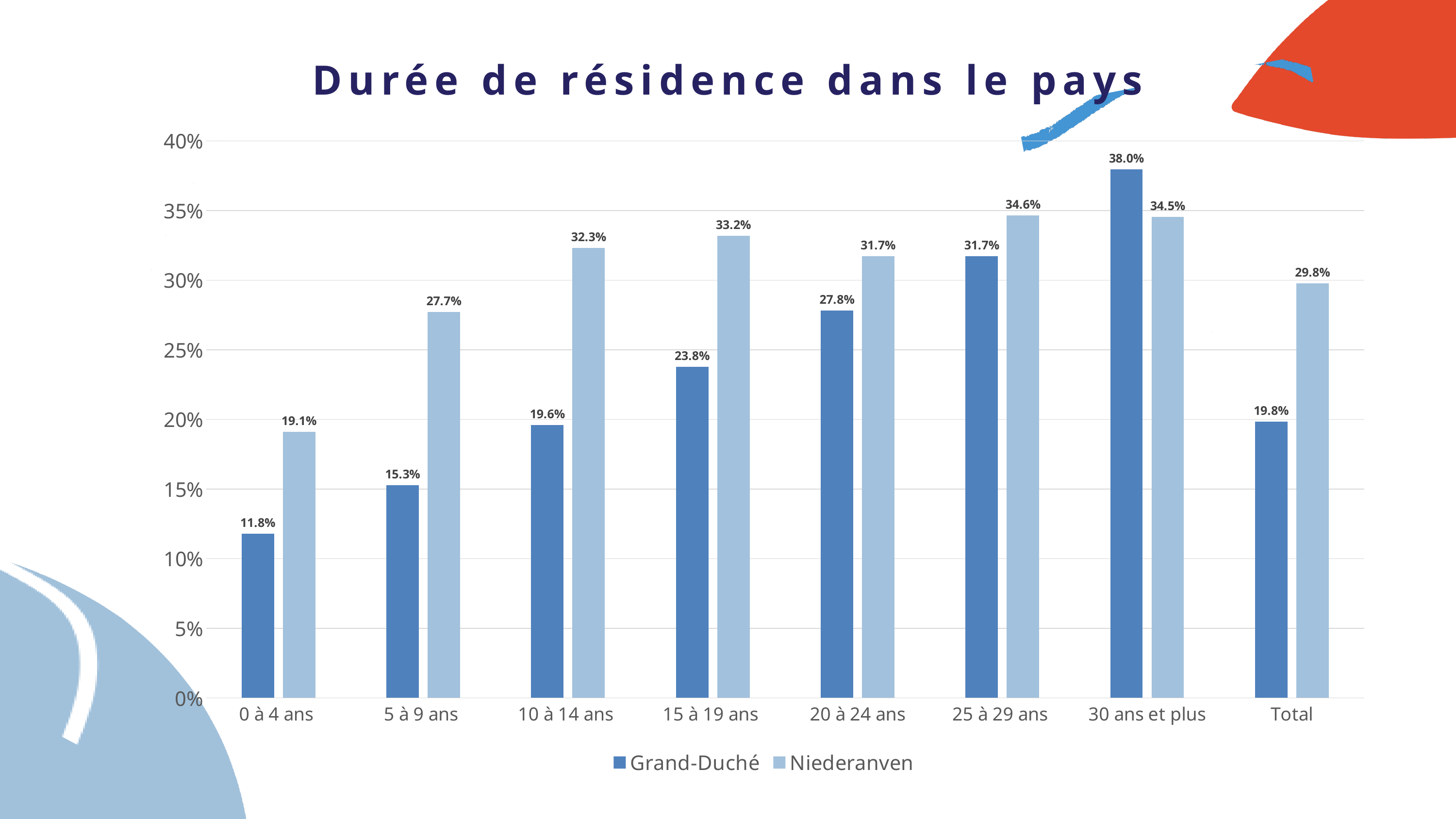
Which category has the lowest Niederanven value? 0 à 4 ans Which is larger for 30 ans et plus: the Grand-Duché value or the Niederanven value? Grand-Duché Which category has the highest Grand-Duché value? 30 ans et plus What is the Grand-Duché value for the 0 à 4 ans category? 11.8% How many series does the legend list? 2 What is the title of the chart? Durée de résidence dans le pays What is the difference between the Niederanven and Grand-Duché values for 5 à 9 ans? 12.4% Is the Grand-Duché value for 15 à 19 ans greater or less than 25%? less What kind of chart is shown on the slide? bar chart How many categories are shown on the x axis? 8 What is the Niederanven value for the 10 à 14 ans category? 32.3% What is the Niederanven value for the Total category? 29.8%